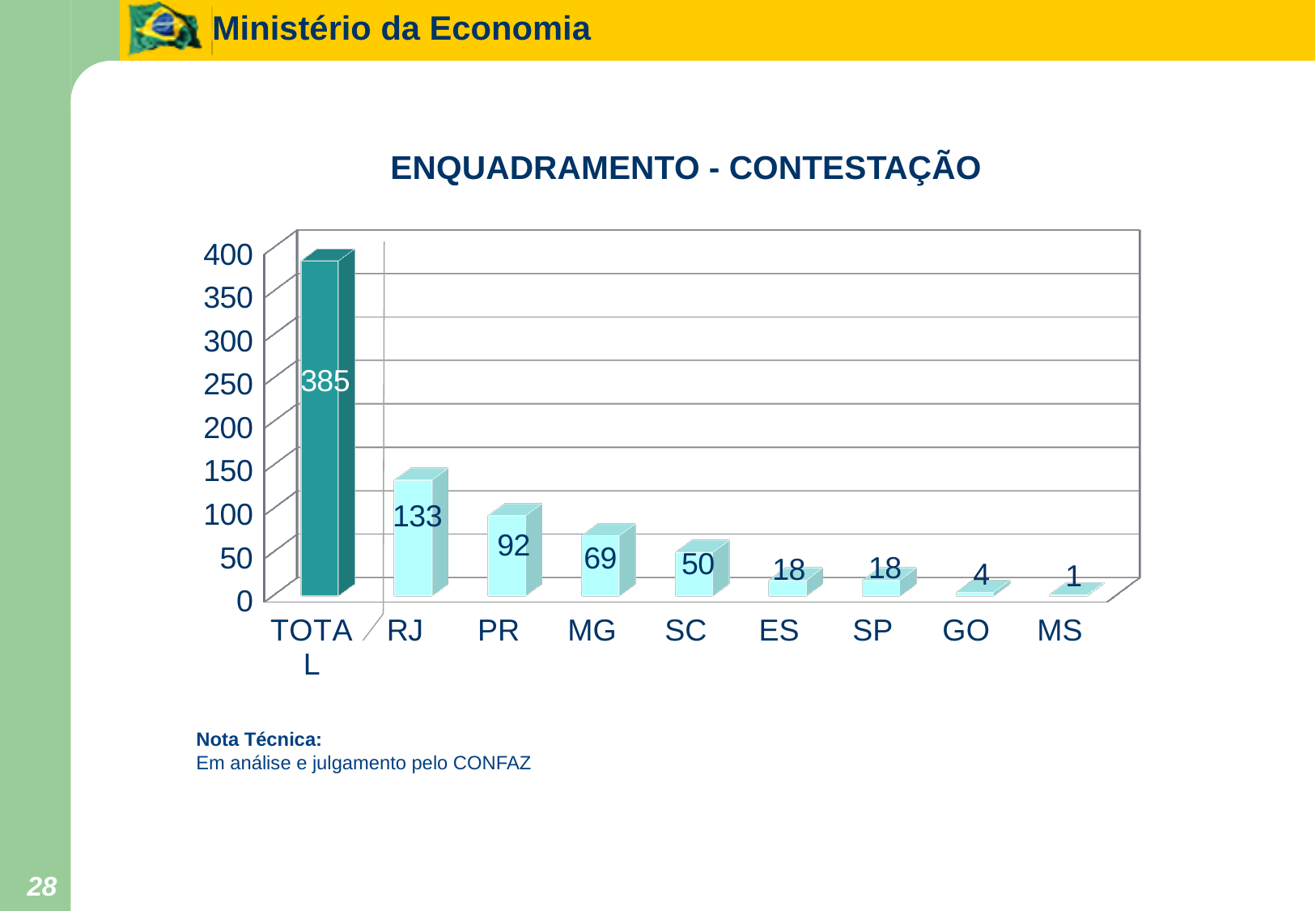
What is the difference between the values for RJ and PR? 41 What is the value for SC? 50 What is the value for RJ? 133 Excluding the TOTAL bar, which state has the highest value? RJ Is the value for PR greater or less than 100? less What is the value for the TOTAL bar? 385 How many categories are shown on the x axis? 9 What is the value for MS? 1 What is the title of the chart? ENQUADRAMENTO - CONTESTAÇÃO Which category has the lowest value? MS What kind of chart is shown on the slide? bar chart Which is larger, the value for MG or the value for SC? MG